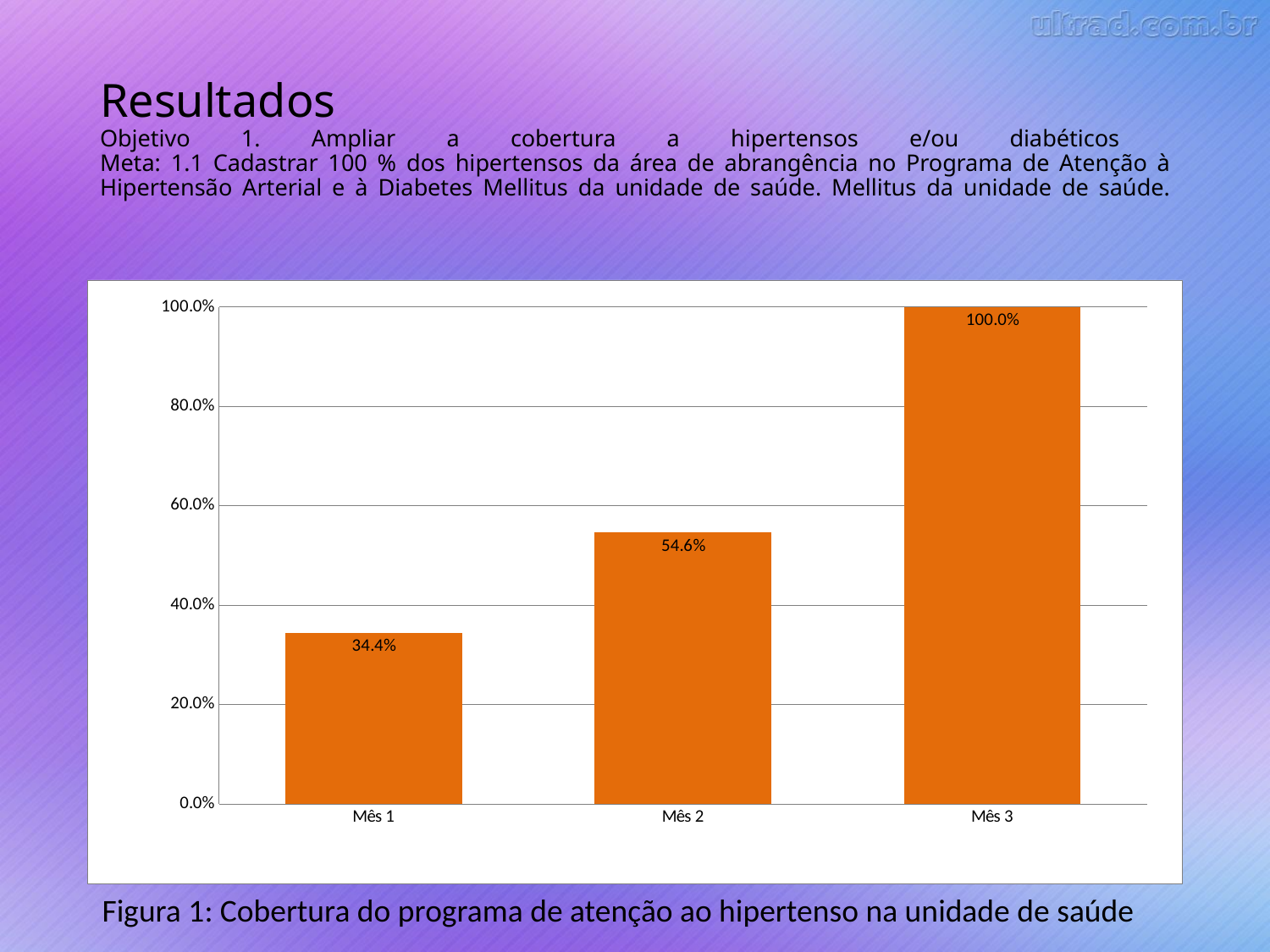
How many months are shown on the x axis? 3 What is the difference between the values for Mês 2 and Mês 1? 20.2% Is the value for Mês 2 greater or less than 60.0%? less Do the values rise or fall from Mês 1 to Mês 3? rise What is the value for Mês 3? 100.0% Which month has the lowest value? Mês 1 What is the value for Mês 1? 34.4% What is the value for Mês 2? 54.6% What kind of chart is shown on the slide? bar chart What is the difference between the values for Mês 3 and Mês 2? 45.4% Which month has the highest value? Mês 3 Which is larger, the value for Mês 1 or the value for Mês 2? Mês 2